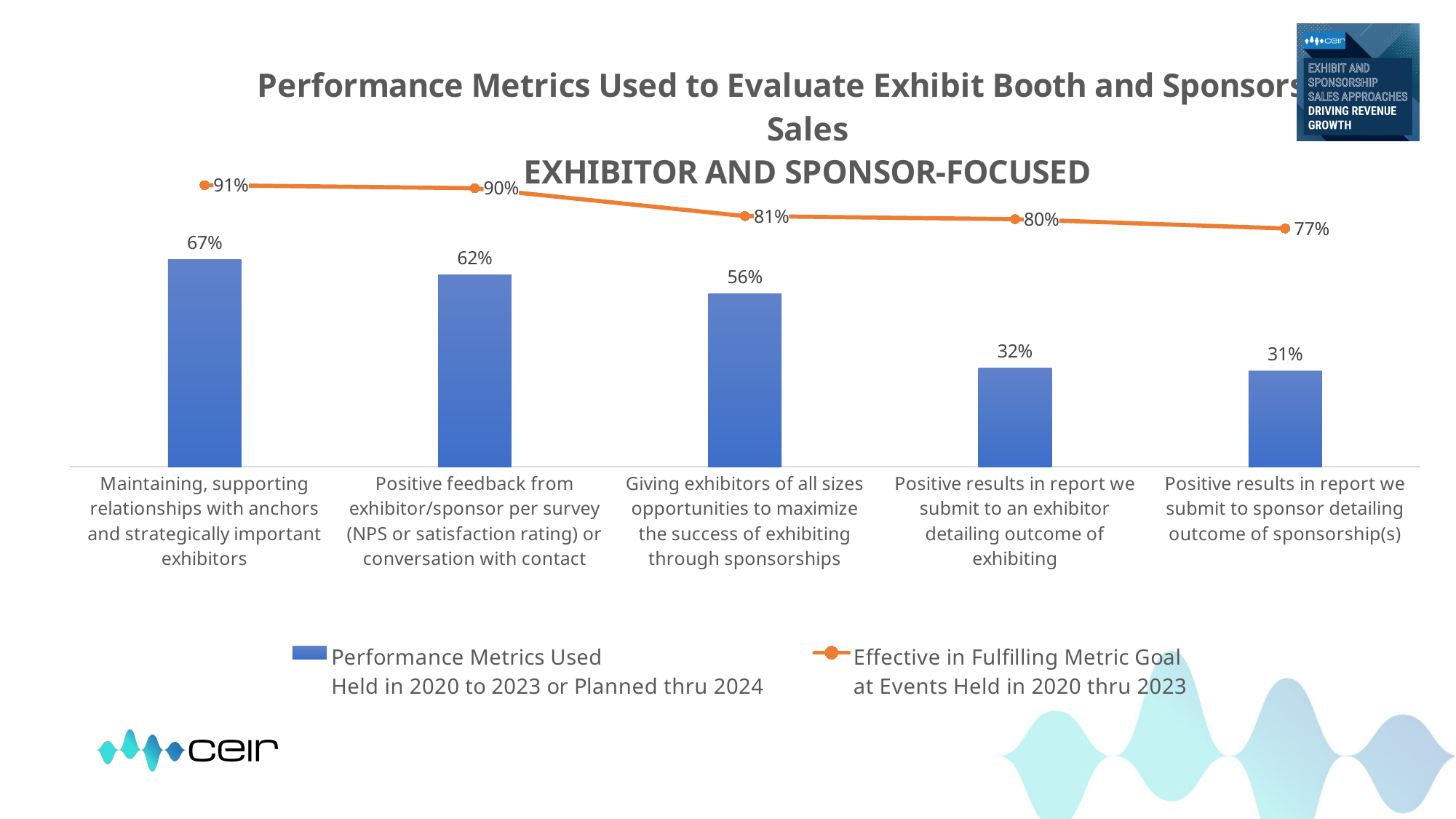
How many categories are shown on the x axis? 5 Do the 'Effective in Fulfilling Metric Goal' values rise or fall from left to right along the x axis? Fall What is the 'Effective in Fulfilling Metric Goal' value for 'Giving exhibitors of all sizes opportunities to maximize the success of exhibiting through sponsorships'? 81% Which category has the lowest 'Effective in Fulfilling Metric Goal' value? Positive results in report we submit to sponsor detailing outcome of sponsorship(s) What percentage of respondents use 'Positive feedback from exhibitor/sponsor per survey (NPS or satisfaction rating) or conversation with contact' as a performance metric? 62% What is the difference between the 'Performance Metrics Used' values for 'Maintaining, supporting relationships with anchors and strategically important exhibitors' and 'Positive results in report we submit to an exhibitor detailing outcome of exhibiting'? 35% Which category has the highest 'Performance Metrics Used' value? Maintaining, supporting relationships with anchors and strategically important exhibitors What is the 'Performance Metrics Used' value for 'Positive results in report we submit to sponsor detailing outcome of sponsorship(s)'? 31% What kind of chart is shown on the slide? Combined bar and line chart For 'Positive results in report we submit to an exhibitor detailing outcome of exhibiting', which is larger: the 'Performance Metrics Used' value or the 'Effective in Fulfilling Metric Goal' value? Effective in Fulfilling Metric Goal How many series does the legend list? 2 What colour is the 'Effective in Fulfilling Metric Goal' line? Orange